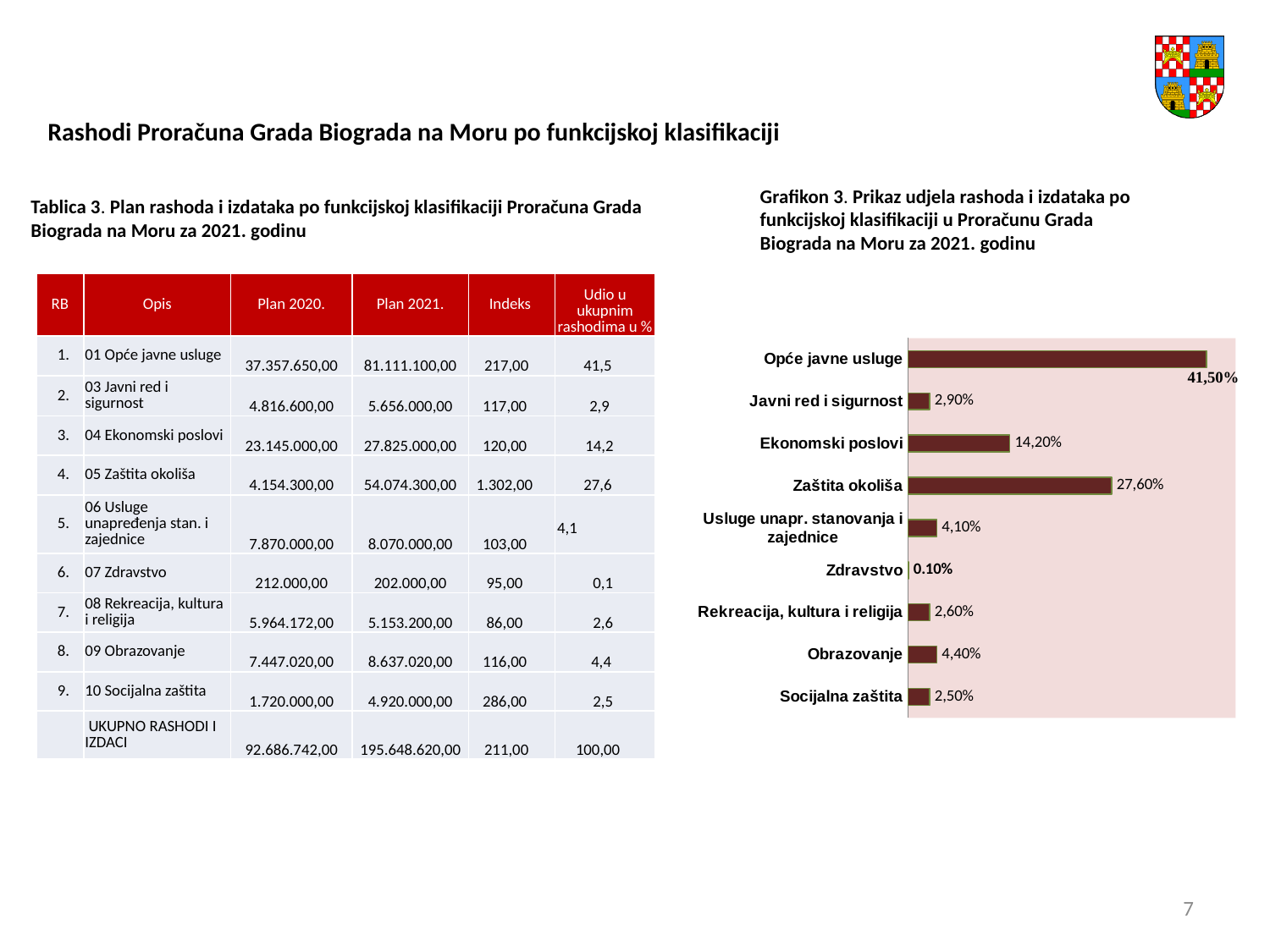
What is the value for Ekonomski poslovi in the chart? 14,20% What kind of chart is shown on the slide? bar chart Which is larger, the value for Javni red i sigurnost or the value for Rekreacija, kultura i religija? Javni red i sigurnost What is the value for Zaštita okoliša in the chart? 27,60% What is the value for Opće javne usluge in the chart? 41,50% What is the title of the chart on the slide? Grafikon 3. Prikaz udjela rashoda i izdataka po funkcijskoj klasifikaciji u Proračunu Grada Biograda na Moru za 2021. godinu How many categories are shown in the chart? 9 What is the difference between the values for Opće javne usluge and Zaštita okoliša? 13,90% Which category has the highest value in the chart? Opće javne usluge What is the value for Obrazovanje in the chart? 4,40% Which category has the lowest value in the chart? Zdravstvo What is the value for Zdravstvo in the chart? 0.10%